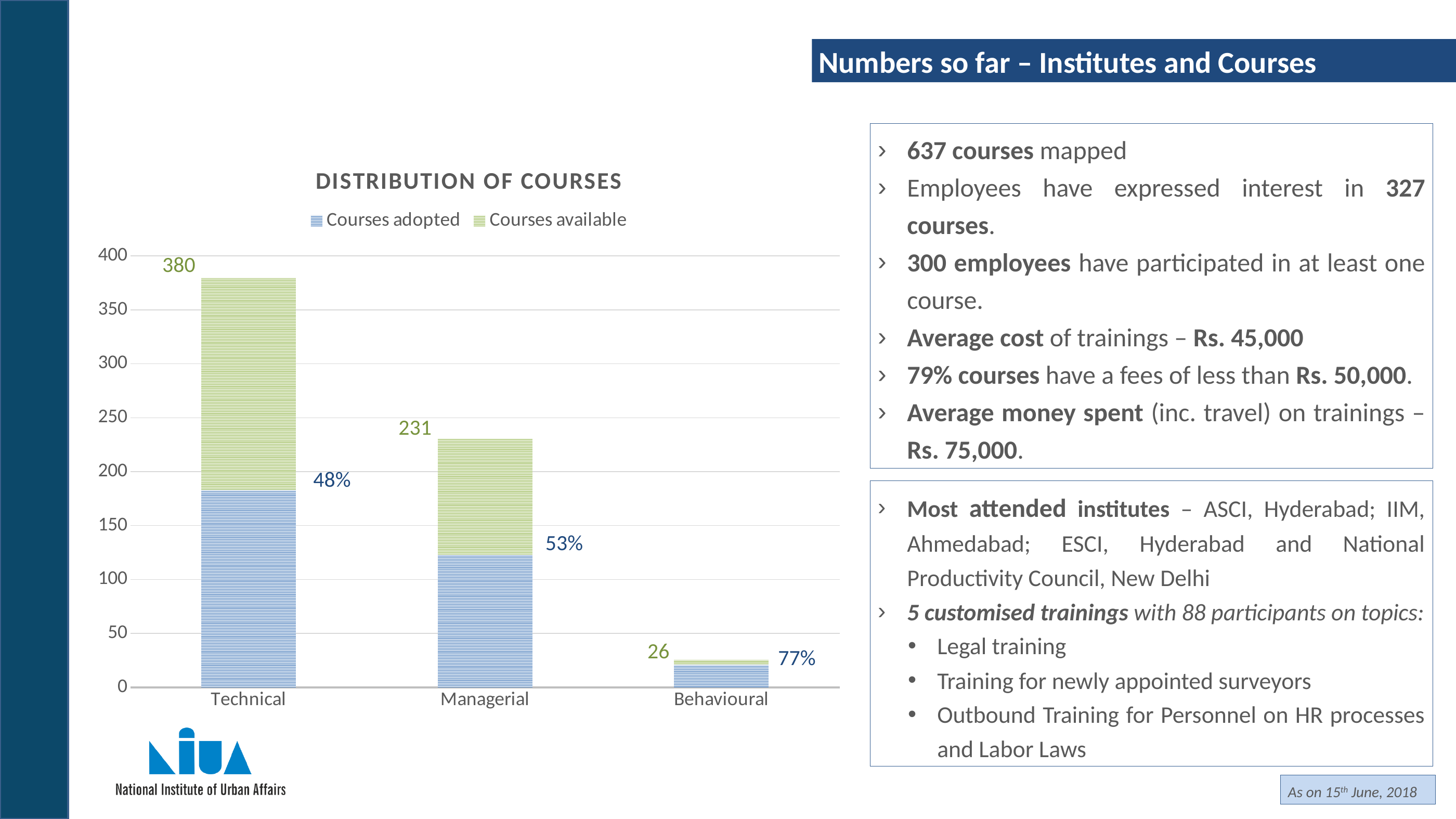
What kind of chart is shown on the slide? Stacked bar chart Which category has the tallest bar? Technical What is the title of the chart? DISTRIBUTION OF COURSES Which category has the shortest bar? Behavioural What value is printed at the top of the Technical bar? 380 What percentage label is shown next to the Behavioural bar? 77% How many series does the chart legend list? 2 What value is printed at the top of the Managerial bar? 231 What value is printed at the top of the Behavioural bar? 26 What is the difference between the values printed at the top of the Technical and Managerial bars? 149 How many categories are shown on the x axis of the chart? 3 Is the Courses adopted portion of the Technical bar greater or less than 150? greater